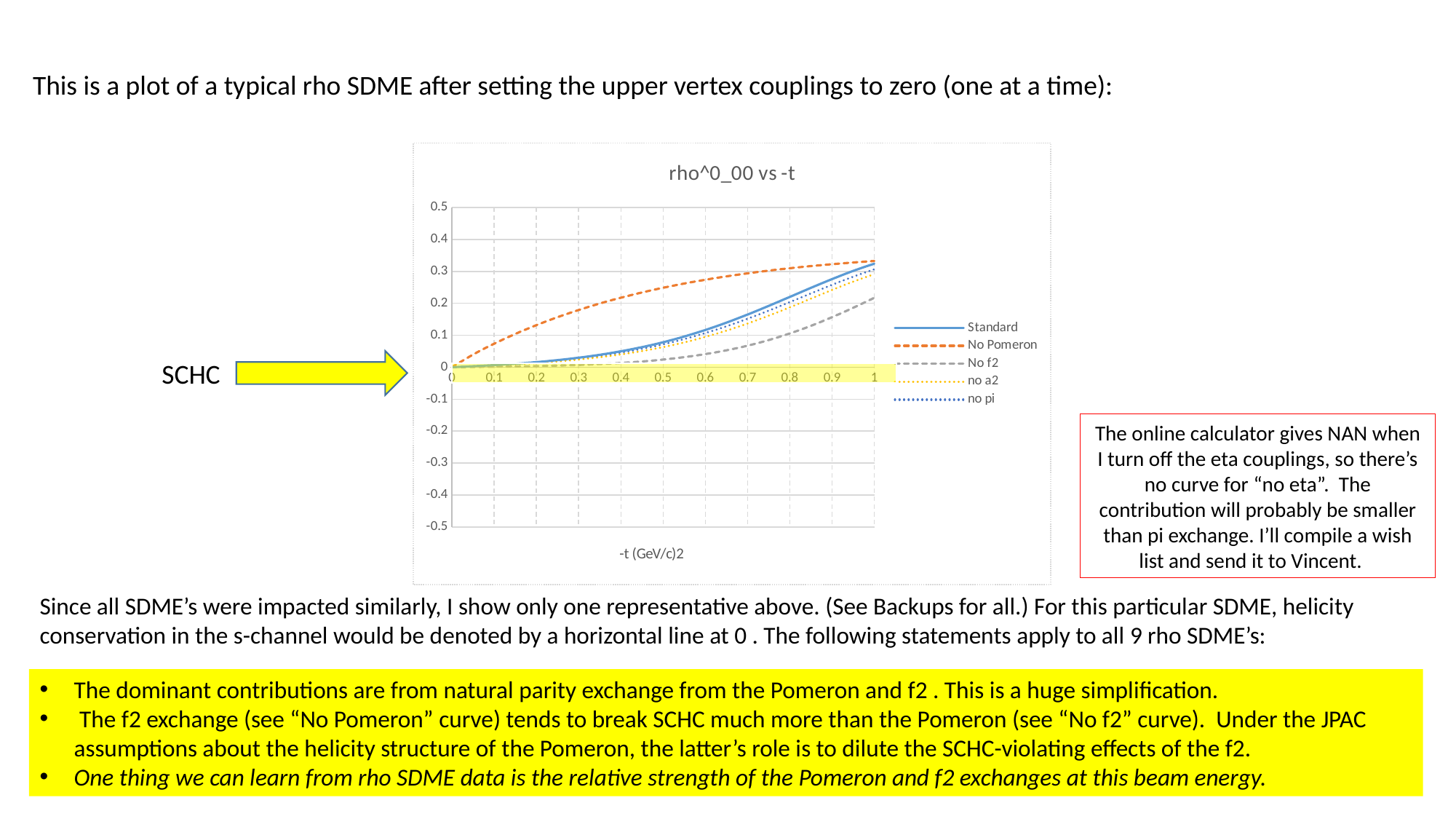
How many series does the legend of the chart list? 5 What kind of chart is shown on the slide? line chart Is the value of the No Pomeron curve at -t = 0.5 greater or less than 0.2? greater What is the label on the x axis of the chart? -t (GeV/c)2 At -t = 0.5, which is larger, the No Pomeron curve or the No f2 curve? No Pomeron What is the title of the chart? rho^0_00 vs -t At -t = 1, which is larger, the Standard curve or the No f2 curve? Standard Is the value of the Standard curve at -t = 0.5 greater or less than 0.1? less Which series has the highest value at -t = 0.5? No Pomeron Which series has the lowest value at -t = 0.8? No f2 Does the No Pomeron curve rise or fall as -t increases from 0 to 1? rise Is the value of the No f2 curve at -t = 1 greater or less than 0.3? less